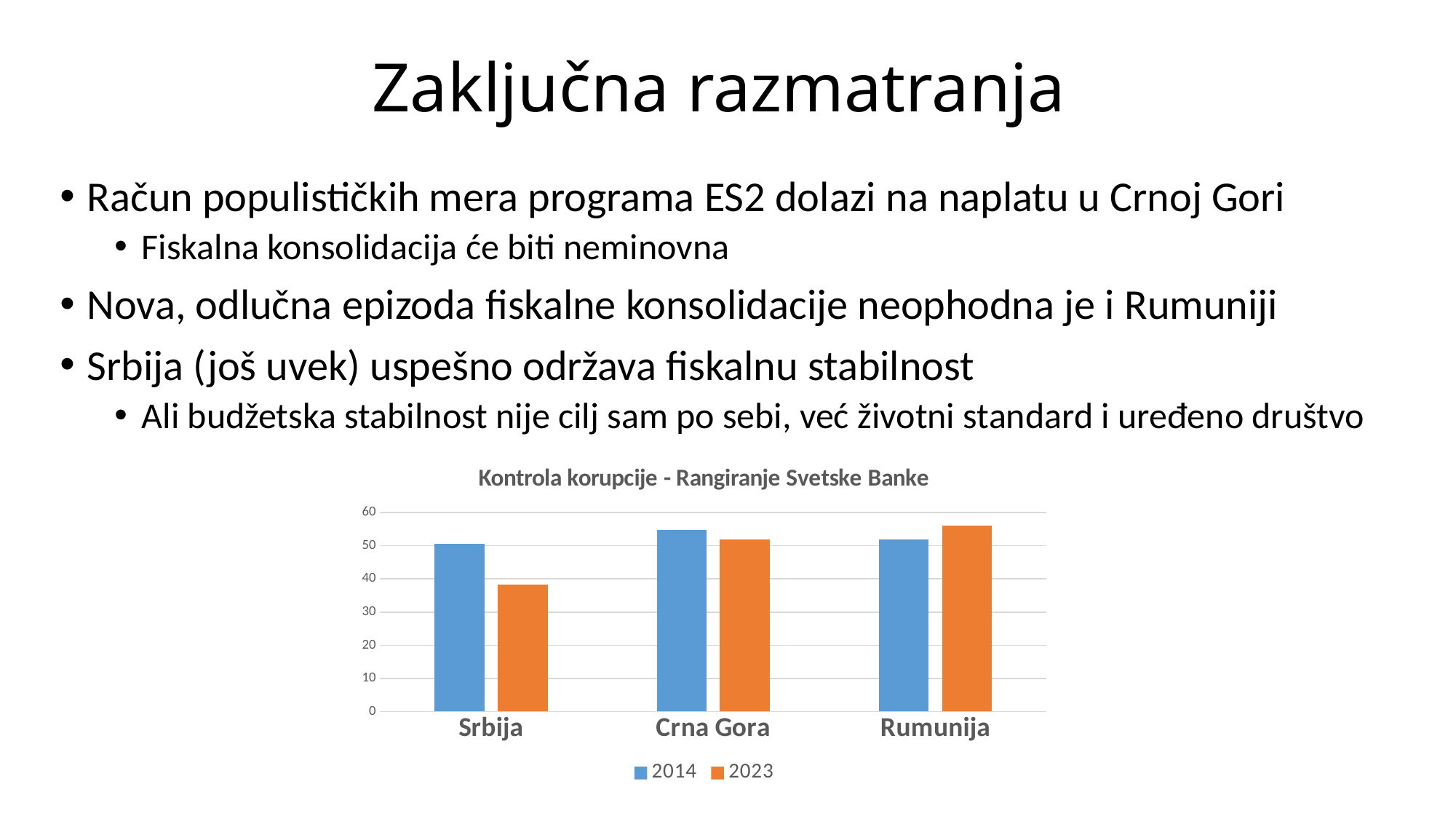
Which country has the lowest value for 2023? Srbija For Srbija, which is larger: the 2014 value or the 2023 value? 2014 How many series does the chart legend list? 2 How many countries are shown on the x axis of the chart? 3 What is the title of the chart? Kontrola korupcije - Rangiranje Svetske Banke Which country has the highest value for 2023? Rumunija Is the 2023 value for Srbija greater or less than 40? less Is the 2014 value for Crna Gora greater or less than 50? greater What kind of chart is shown on the slide? bar chart For Rumunija, which is larger: the 2014 value or the 2023 value? 2023 Which years are listed in the chart legend? 2014 and 2023 Which country has the lowest value for 2014? Srbija